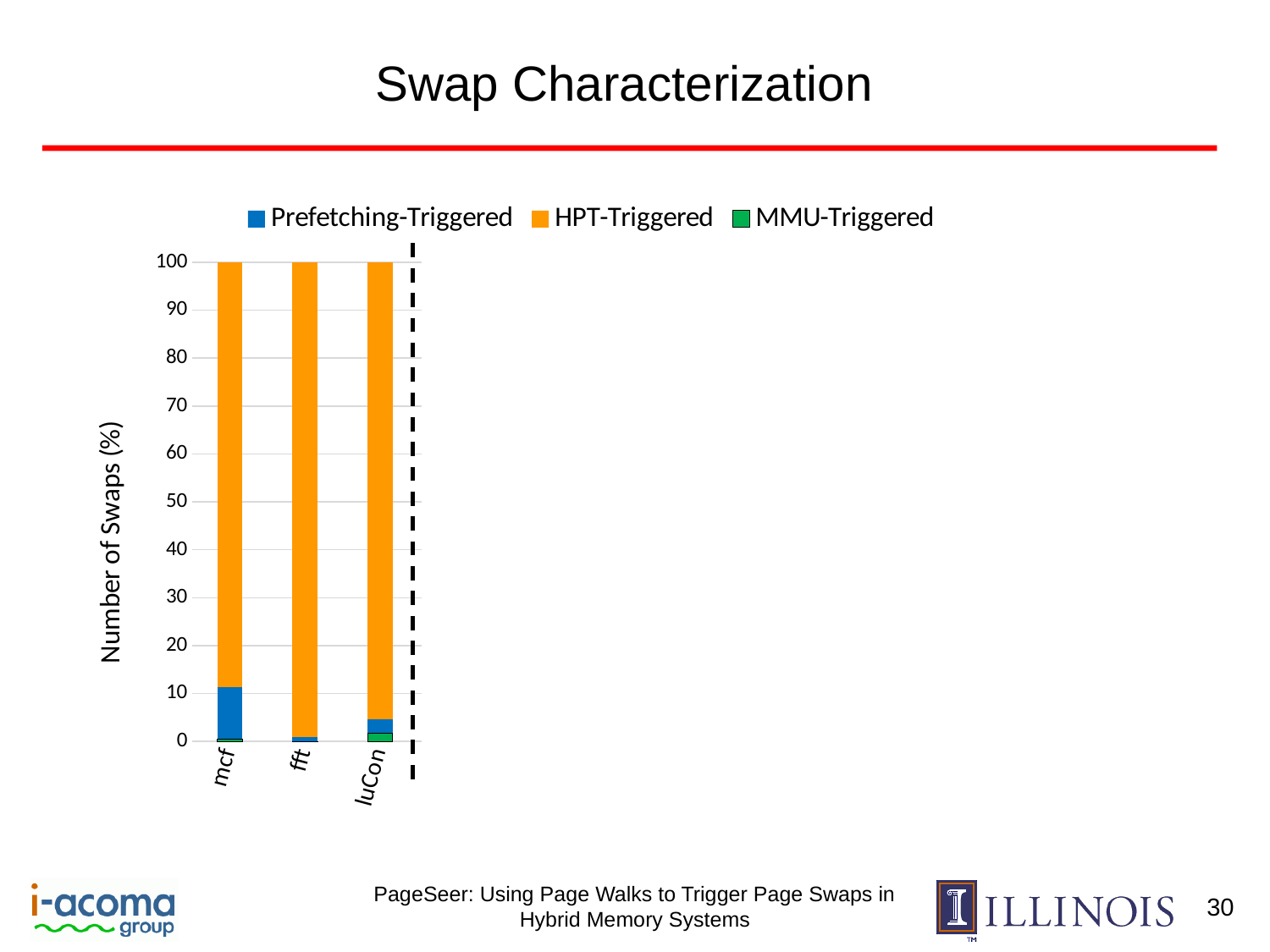
What kind of chart is shown on the slide? stacked bar chart Is the HPT-Triggered value for fft greater or less than 90? greater How many categories (benchmarks) are shown on the x axis? 3 Which benchmark has the smallest HPT-Triggered share? mcf Is the Prefetching-Triggered share for mcf larger or smaller than that for fft? larger How many series does the legend list? 3 Which benchmark has the largest Prefetching-Triggered share? mcf Which benchmark has the largest HPT-Triggered share? fft Is the Prefetching-Triggered value for mcf greater or less than 20? less What is the total height of the stacked bar for mcf? 100 Which colour represents the HPT-Triggered series in the legend? orange What is the y-axis title of the chart? Number of Swaps (%)